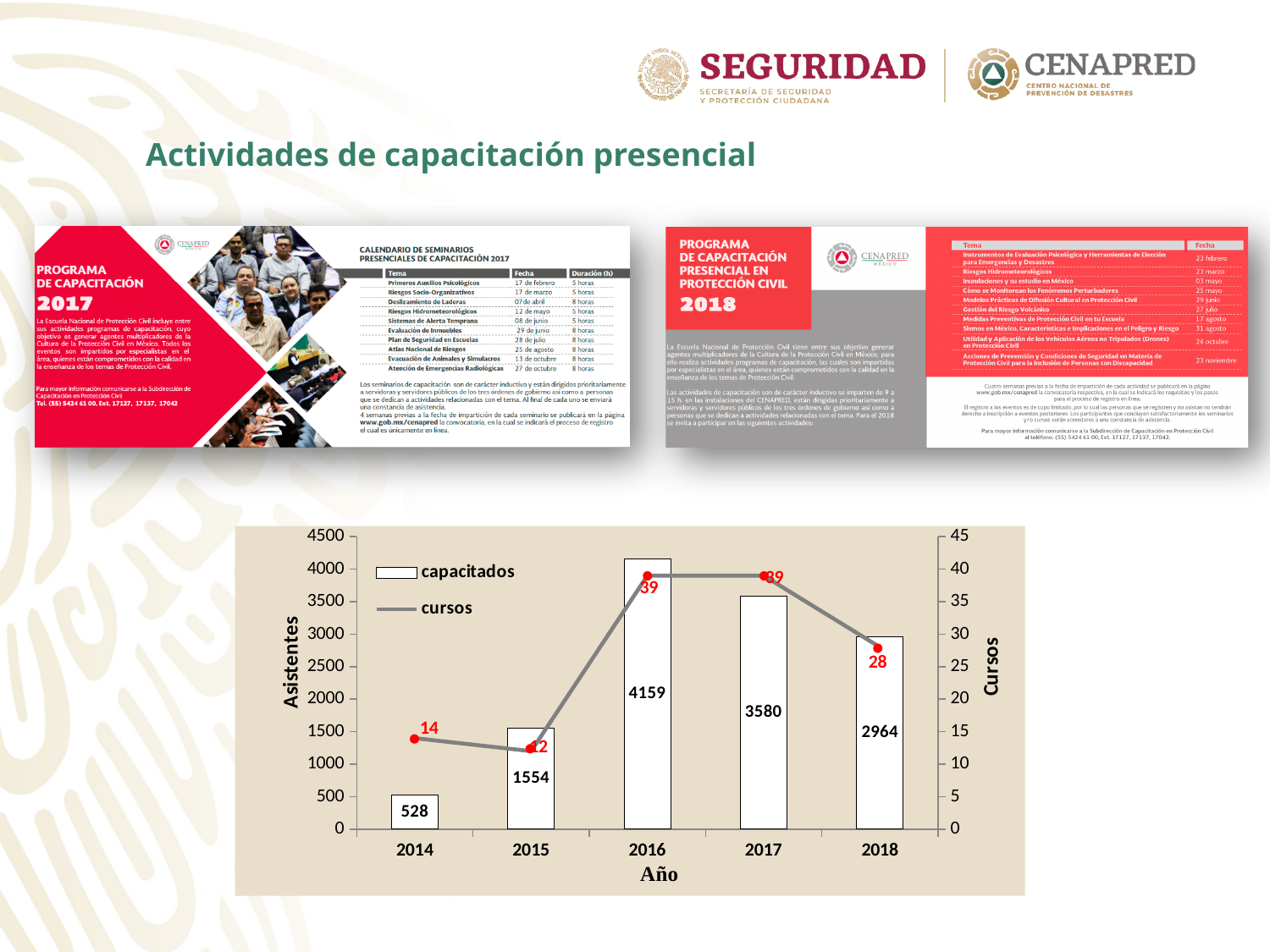
What is the value of capacitados for 2016? 4159 What is the difference in capacitados between 2016 and 2017? 579 How many years are shown on the x axis of the chart? 5 Do the capacitados values rise or fall from 2016 to 2018? fall What is the difference in cursos between 2016 and 2018? 11 What is the value of capacitados for 2014? 528 Which year had more capacitados, 2015 or 2018? 2018 What is the label of the left vertical axis of the chart? Asistentes How many series does the chart legend list? 2 Which year has the highest number of capacitados? 2016 Which year has the lowest number of cursos? 2015 How many cursos were held in 2018? 28